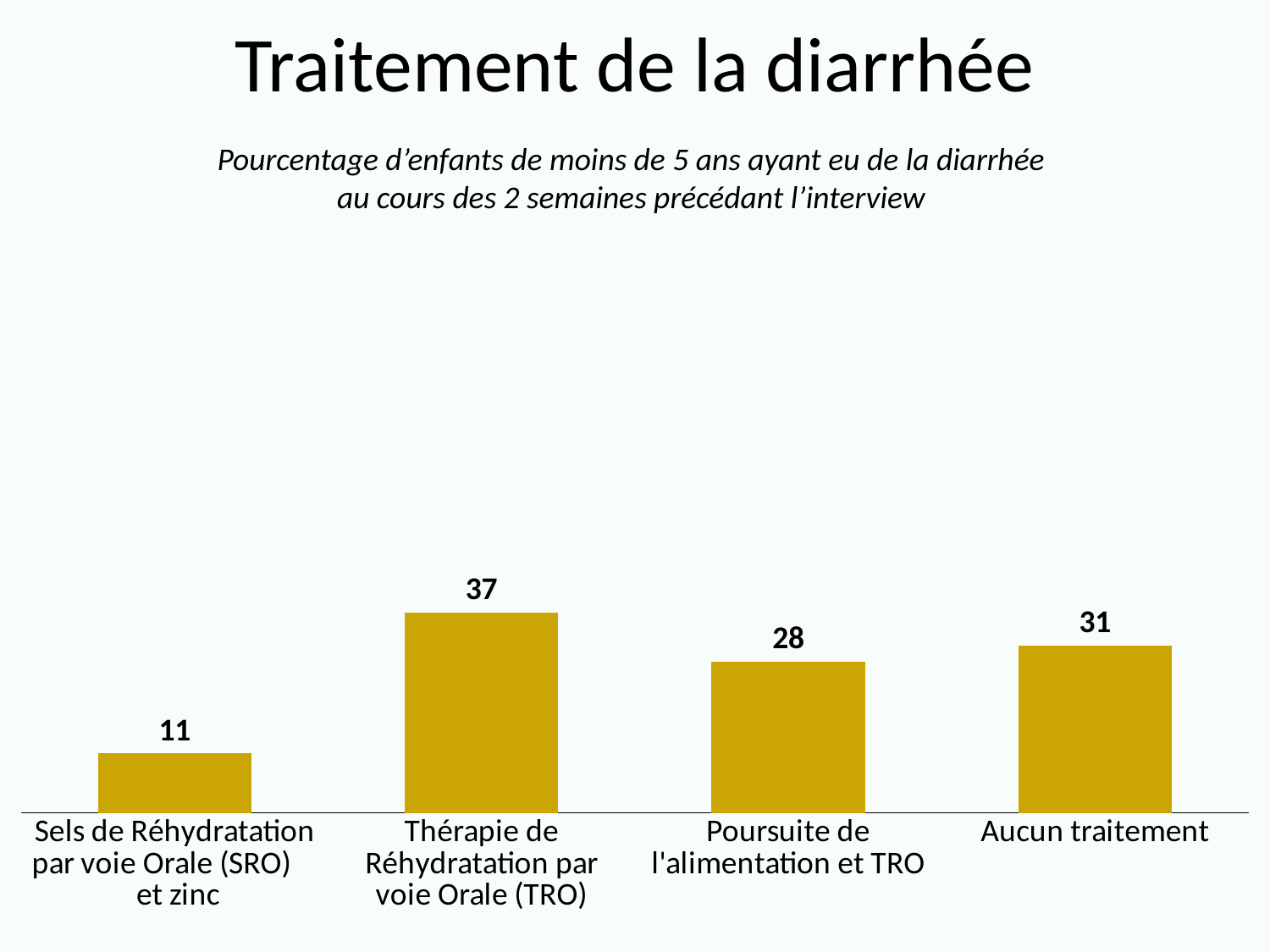
What is the difference between the values for Aucun traitement and Poursuite de l'alimentation et TRO? 3 What is the value for Thérapie de Réhydratation par voie Orale (TRO)? 37 What is the value for Poursuite de l'alimentation et TRO? 28 Which category has the lowest value? Sels de Réhydratation par voie Orale (SRO) et zinc What is the difference between the values for Thérapie de Réhydratation par voie Orale (TRO) and Sels de Réhydratation par voie Orale (SRO) et zinc? 26 What is the value for Sels de Réhydratation par voie Orale (SRO) et zinc? 11 What is the value for Aucun traitement? 31 Which is larger, the value for Aucun traitement or the value for Poursuite de l'alimentation et TRO? Aucun traitement What is the title of the slide? Traitement de la diarrhée What kind of chart is shown on the slide? Bar chart How many categories are shown in the chart? 4 Which category has the highest value? Thérapie de Réhydratation par voie Orale (TRO)